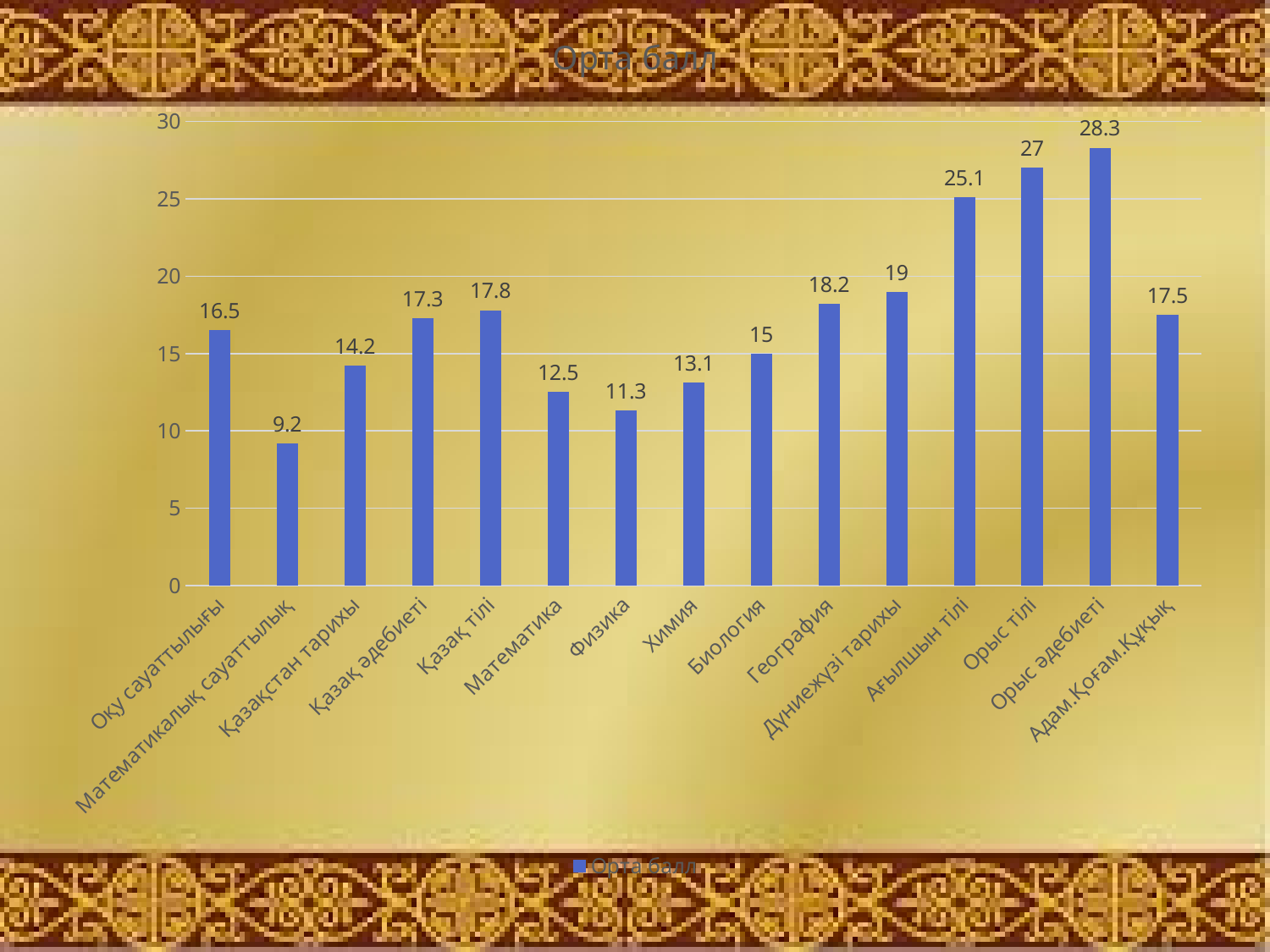
Which category has the highest value? Орыс әдебиеті Which is larger, the value for География or the value for Биология? География What is the value for Ағылшын тілі? 25.1 How many series does the legend list? 1 What is the difference between the values for Орыс тілі and Қазақ тілі? 9.2 What is the title of the chart? Орта балл What is the value for Математика? 12.5 What is the value for Физика? 11.3 What kind of chart is shown on the slide? bar chart How many categories are shown on the x axis? 15 Which category has the lowest value? Математикалық сауаттылық Is the value for Дүниежүзі тарихы greater or less than 20? less